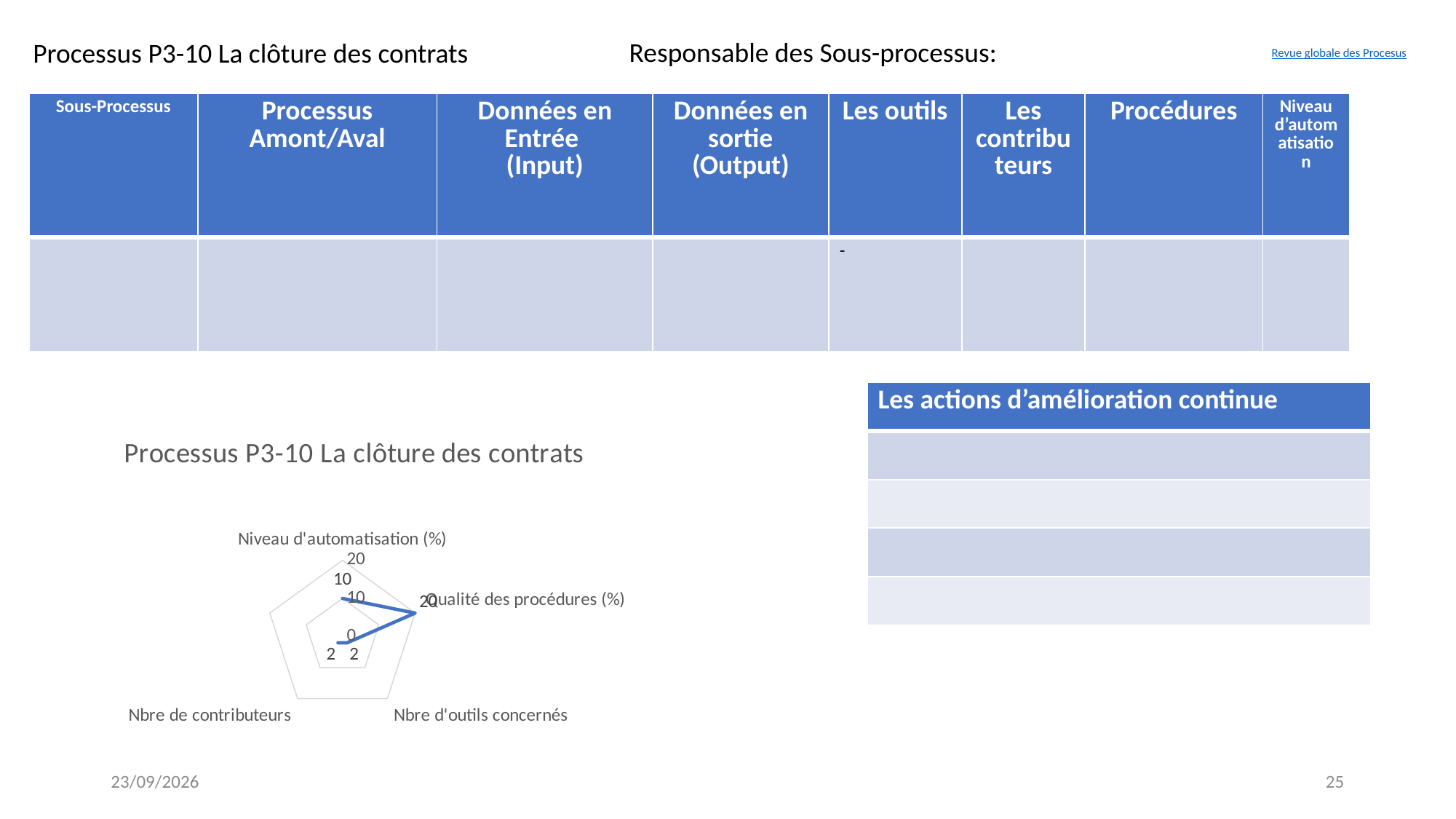
What is the difference between the value for Qualité des procédures (%) and the value for Niveau d'automatisation (%)? 10 Is the value for Qualité des procédures (%) greater or less than 10? greater What is the highest tick value shown on the chart's scale? 20 What is the value for Nbre d'outils concernés in the chart? 2 Which labelled axis has the highest value in the chart? Qualité des procédures (%) What is the value for Qualité des procédures (%) in the chart? 20 What is the value for Nbre de contributeurs in the chart? 2 What is the title of the chart? Processus P3-10 La clôture des contrats Which is larger, the value for Niveau d'automatisation (%) or the value for Qualité des procédures (%)? Qualité des procédures (%) How many axes does the radar chart have? 5 What is the value for Niveau d'automatisation (%) in the chart? 10 What kind of chart is shown on the slide? radar chart